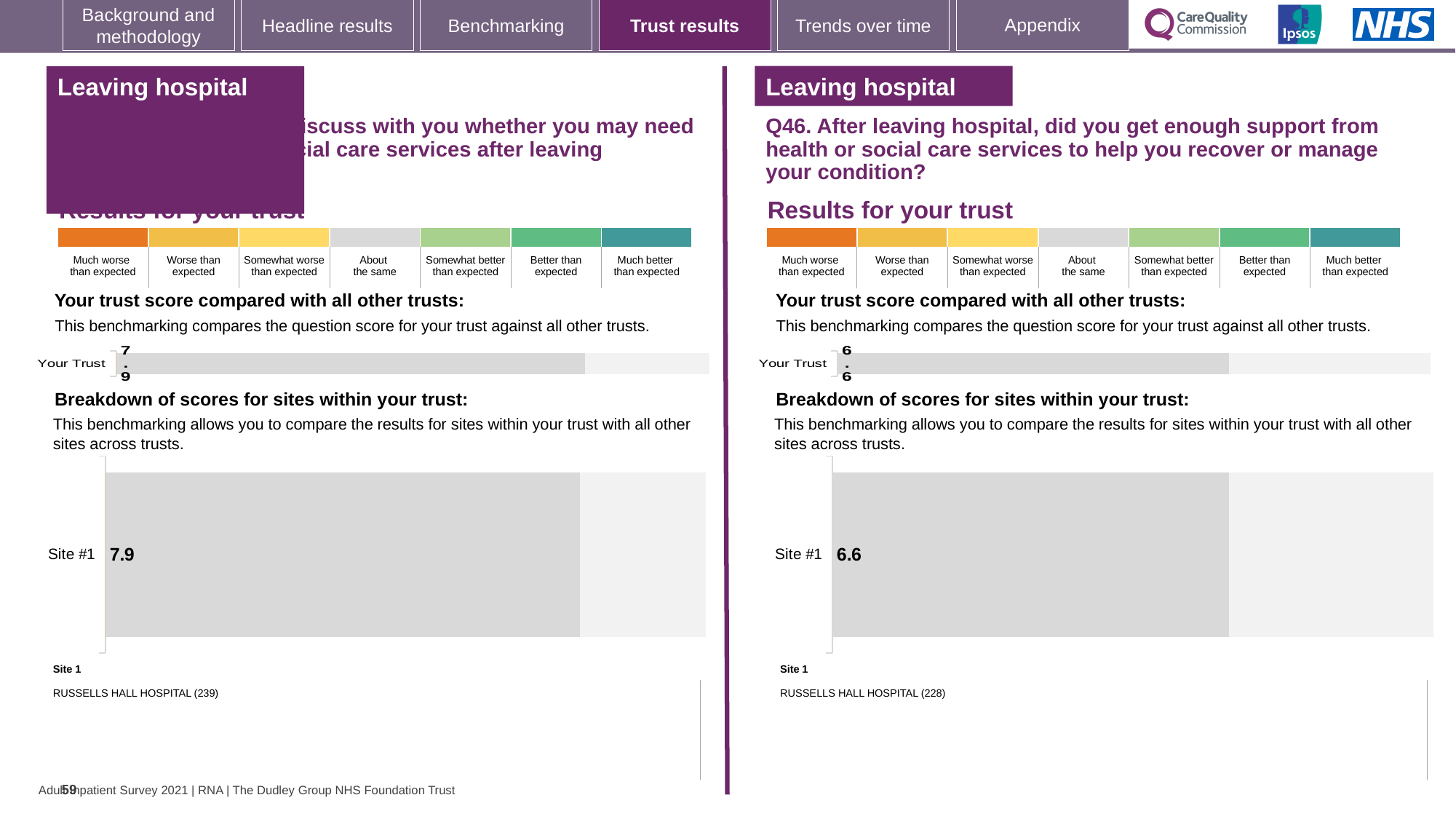
On the left-hand chart, what is the score shown for Your Trust? 7.9 How many sites are shown in the site breakdown chart on the right-hand side for Q46? 1 On the right-hand chart for Q46, which site is listed as Site 1? RUSSELLS HALL HOSPITAL (228) What is the difference between the Site #1 score on the left-hand chart and the Site #1 score on the right-hand chart for Q46? 1.3 On the left-hand chart, which site is listed as Site 1? RUSSELLS HALL HOSPITAL (239) How many sites are shown in the site breakdown chart on the left-hand side? 1 On the right-hand site breakdown chart for Q46, what is the score for Site #1? 6.6 Which is larger: the Your Trust score on the left-hand chart or the Your Trust score on the right-hand chart for Q46? Left-hand chart (7.9) On the right-hand chart for Q46, what is the score shown for Your Trust? 6.6 What type of chart is used to show the Site #1 score on the right-hand side for Q46? Bar chart On the left-hand site breakdown chart, what is the score for Site #1? 7.9